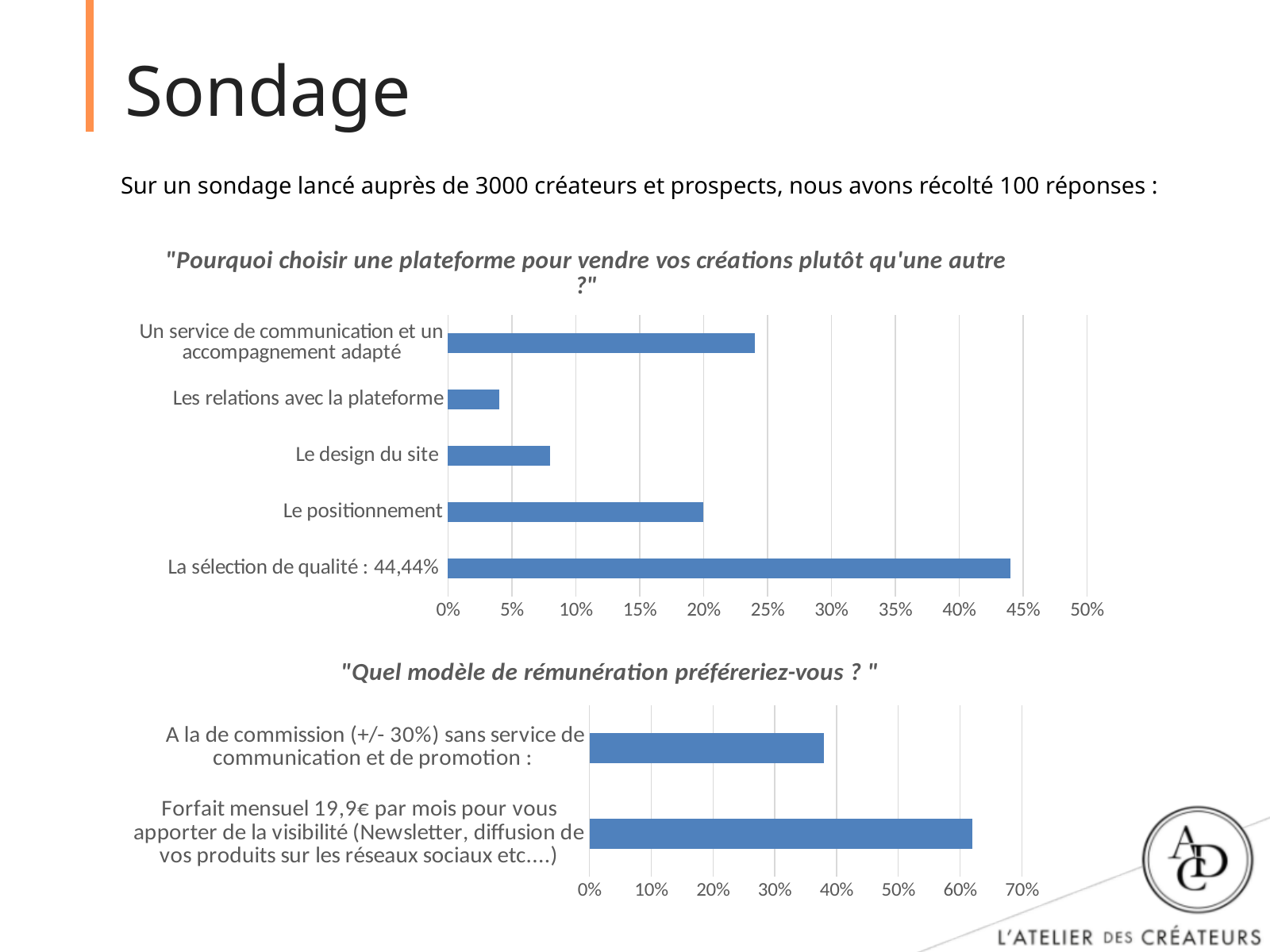
In the chart "Pourquoi choisir une plateforme pour vendre vos créations plutôt qu'une autre ?", which category has the highest value? La sélection de qualité In the chart "Quel modèle de rémunération préféreriez-vous ?", is the value for the "Forfait mensuel 19,9€" option greater or less than 50%? greater In the chart "Pourquoi choisir une plateforme pour vendre vos créations plutôt qu'une autre ?", is the value for "Le design du site" greater or less than 10%? less In the chart "Quel modèle de rémunération préféreriez-vous ?", is the value for "A la de commission (+/- 30%) sans service de communication et de promotion" greater or less than 40%? less In the chart "Pourquoi choisir une plateforme pour vendre vos créations plutôt qu'une autre ?", which is larger: "Le positionnement" or "Le design du site"? Le positionnement In the chart "Quel modèle de rémunération préféreriez-vous ?", how many categories are plotted? 2 In the chart "Pourquoi choisir une plateforme pour vendre vos créations plutôt qu'une autre ?", how many categories are plotted? 5 In the chart "Quel modèle de rémunération préféreriez-vous ?", which category has the highest value? Forfait mensuel 19,9€ par mois pour vous apporter de la visibilité (Newsletter, diffusion de vos produits sur les réseaux sociaux etc....) In the chart "Pourquoi choisir une plateforme pour vendre vos créations plutôt qu'une autre ?", what value is printed for "La sélection de qualité"? 44,44% In the chart "Pourquoi choisir une plateforme pour vendre vos créations plutôt qu'une autre ?", what kind of chart is shown? bar chart In the chart "Pourquoi choisir une plateforme pour vendre vos créations plutôt qu'une autre ?", which category has the lowest value? Les relations avec la plateforme